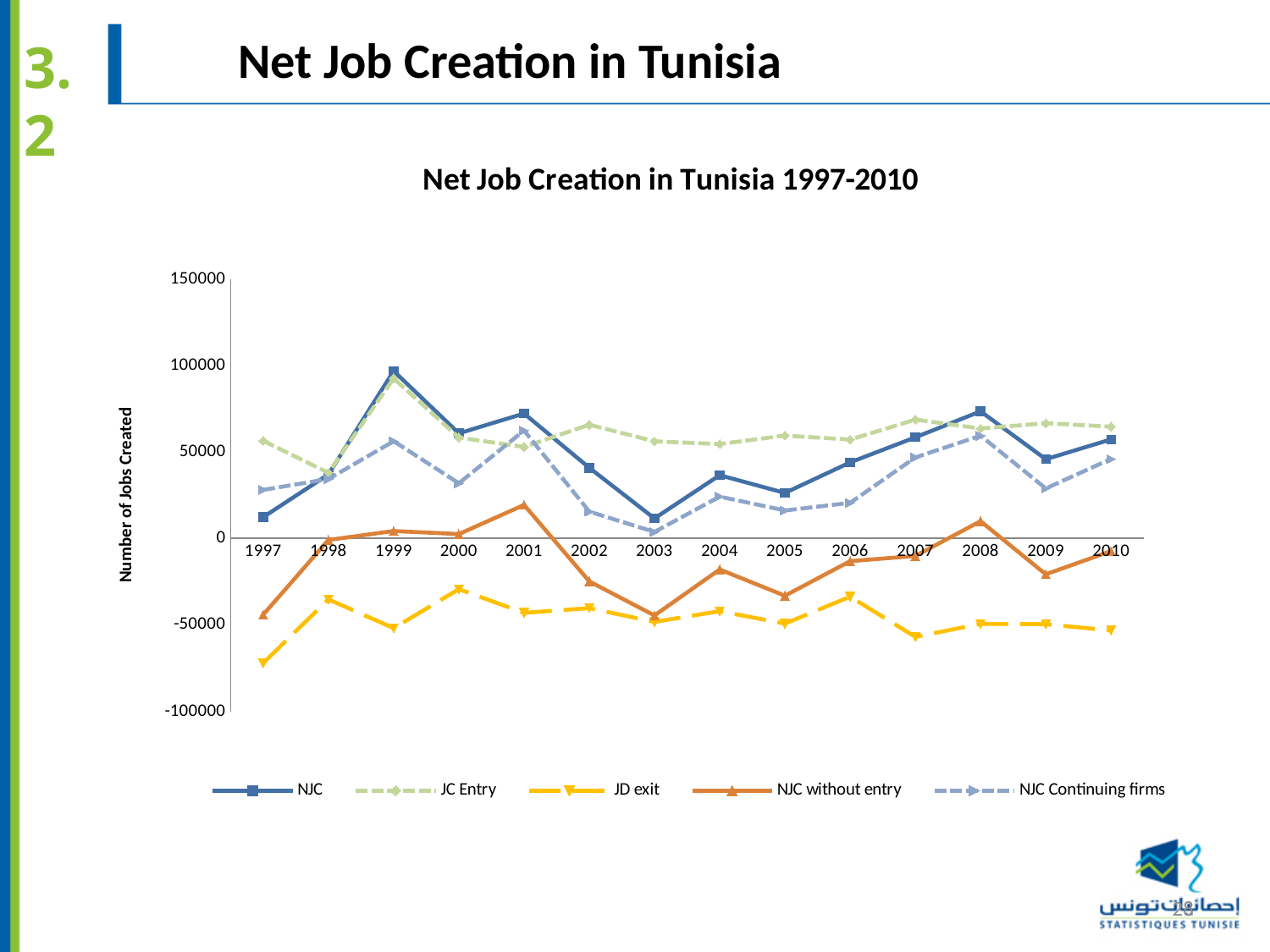
Does the NJC series rise or fall between 2003 and 2008? rise Which year has the larger NJC value, 1999 or 2003? 1999 Is the NJC value for 1999 greater or less than 50000? greater How many years are plotted along the x axis? 14 How many series does the legend list? 5 Is the JD exit value for 1997 greater or less than -50000? less Is the NJC without entry value for 2001 greater or less than 0? greater In which year does the JC Entry series reach its highest value? 1999 What kind of chart is shown on the slide? line chart In which year does the NJC series reach its highest value? 1999 What is the label on the vertical axis of the chart? Number of Jobs Created In which year does the JD exit series reach its lowest value? 1997